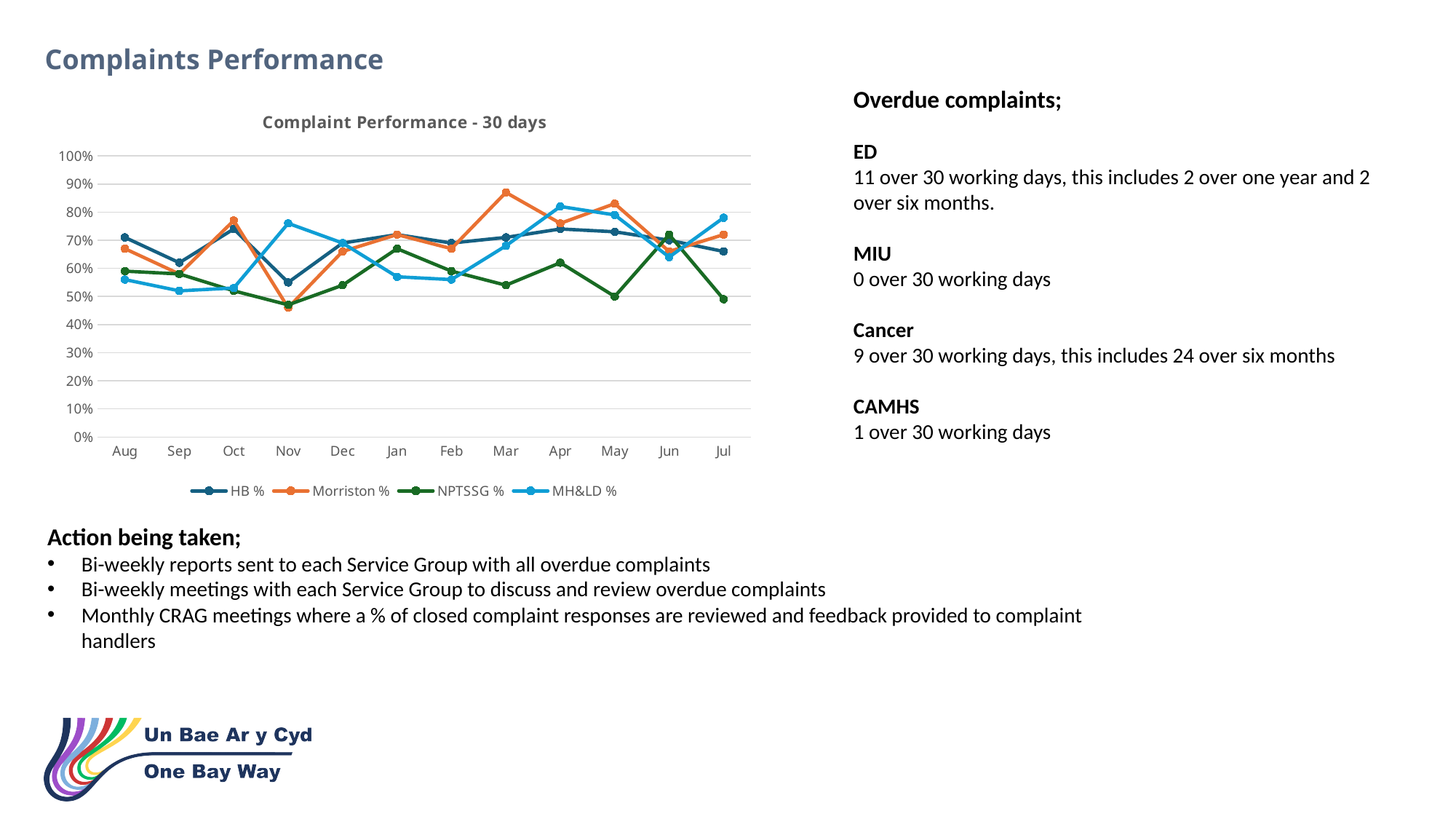
What is the title of the chart? Complaint Performance - 30 days Is the value for NPTSSG % in Nov greater or less than 50%? less Is the value for HB % in Nov greater or less than 60%? less Which series are listed in the chart legend? HB %, Morriston %, NPTSSG %, MH&LD % In which month does Morriston % reach its highest value? Mar Is the value for MH&LD % in Nov greater or less than 70%? greater How many series does the chart legend list? 4 In Mar, which is higher: Morriston % or NPTSSG %? Morriston % Does the NPTSSG % line rise or fall from Jun to Jul? fall What kind of chart is shown on the slide? line chart How many months are plotted along the x axis of the chart? 12